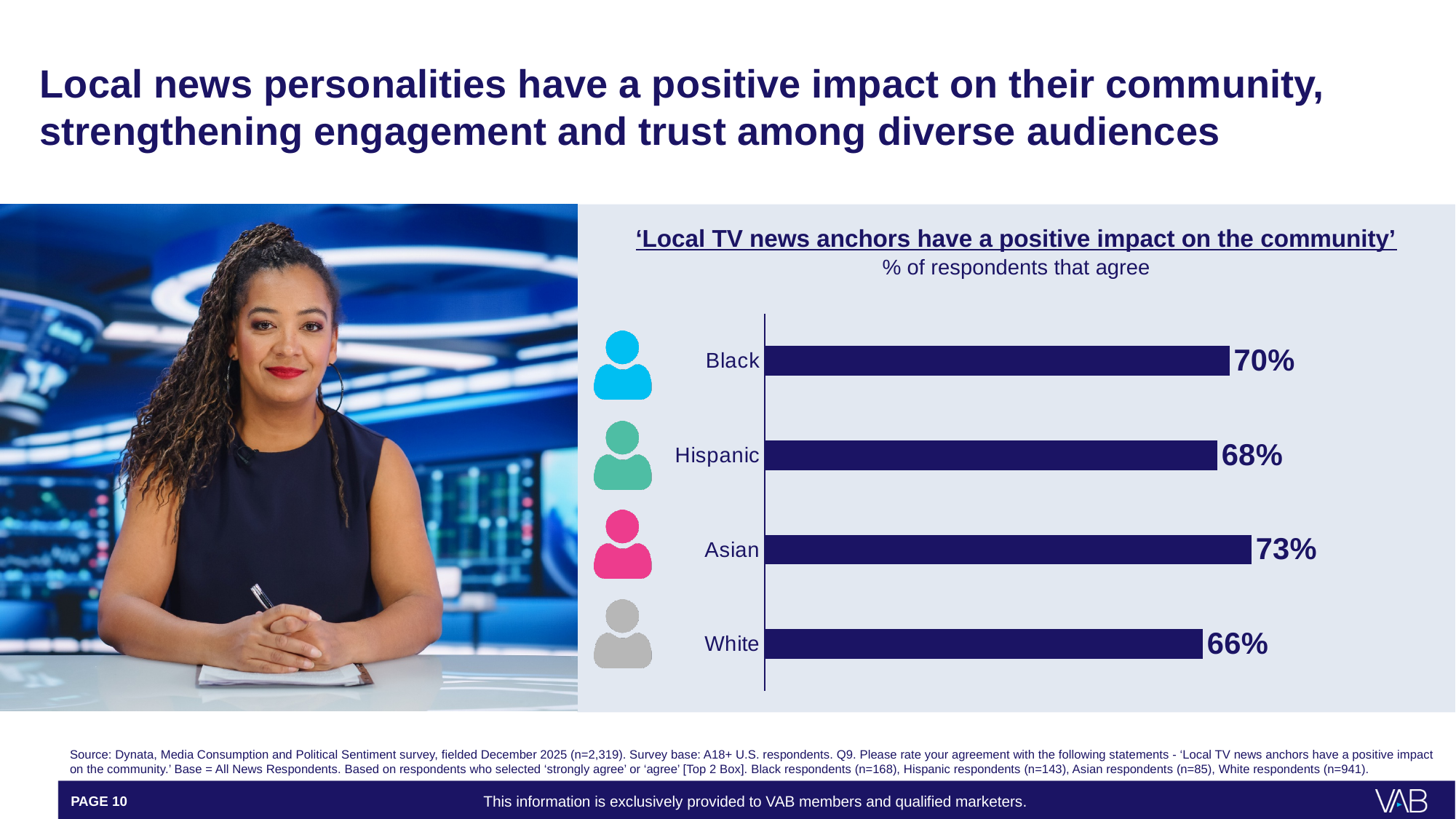
Which group has the highest share of respondents agreeing? Asian What percentage of Asian respondents agree with the statement? 73% Which group has the lowest share of respondents agreeing? White What percentage of Hispanic respondents agree with the statement? 68% What kind of chart is shown on the slide? Bar chart What is the difference in percentage points between Black and Hispanic respondents who agree? 2 What is the difference in percentage points between Asian and White respondents who agree? 7 Which is larger, the value for Black respondents or the value for White respondents? Black What percentage of White respondents agree with the statement? 66% What is the title of the chart? 'Local TV news anchors have a positive impact on the community' What percentage of Black respondents agree that local TV news anchors have a positive impact on the community? 70% How many respondent groups are shown in the chart? 4